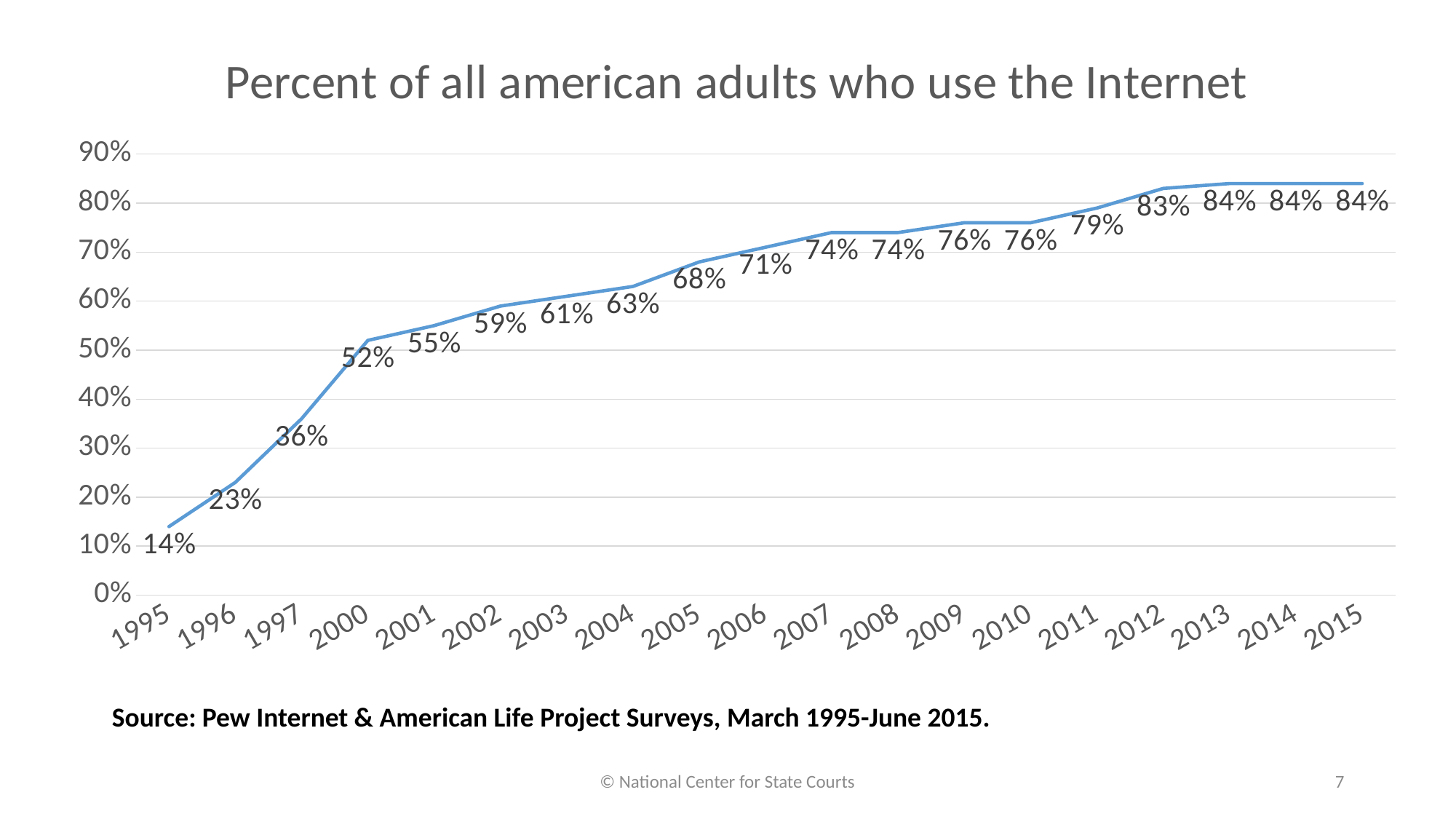
What kind of chart is this? Line chart What percent of American adults used the Internet in 2011? 79% What is the title of the chart? Percent of all american adults who use the Internet How many years are plotted on the x axis? 19 Which year has the lowest value on the chart? 1995 What percent of American adults used the Internet in 1995? 14% Which is larger, the value for 2005 or the value for 2004? 2005 Do the values generally rise or fall from 1995 to 2015? Rise By how many percentage points did the value rise from 1997 to 2000? 16 percentage points What is the difference between the values for 2015 and 1995? 70 percentage points What is the value shown for 2000? 52% What is the highest value shown on the chart? 84%